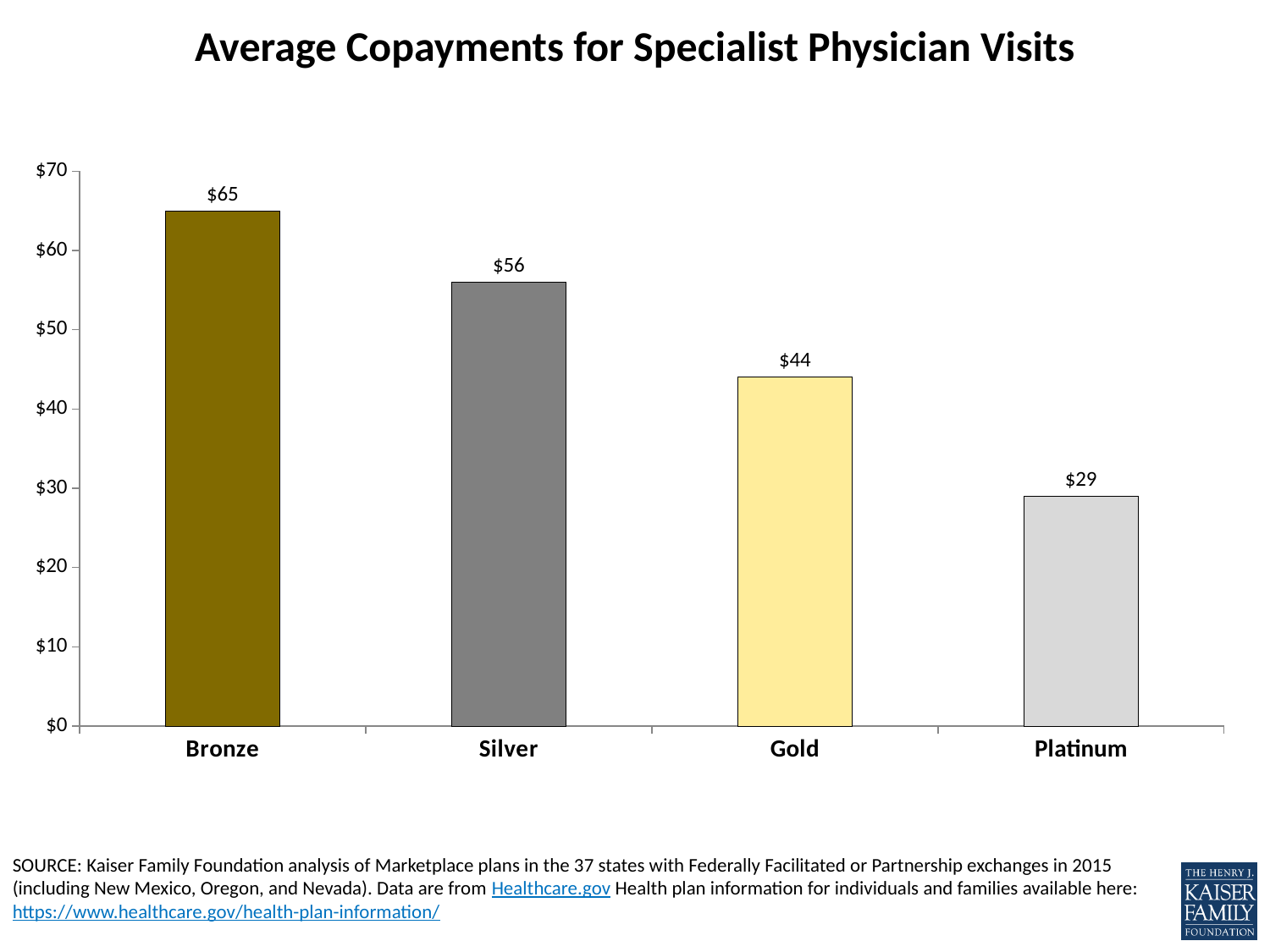
What is the average copayment for specialist physician visits for Platinum plans? $29 Which plan type has the lowest average copayment for specialist physician visits? Platinum How many plan types are shown in the chart? 4 Do the average copayments rise or fall moving from Bronze to Platinum along the x axis? Fall What kind of chart is shown on the slide? Bar chart What is the average copayment for specialist physician visits for Bronze plans? $65 What is the average copayment for specialist physician visits for Silver plans? $56 Which plan type has the highest average copayment for specialist physician visits? Bronze Which has a higher average copayment, Gold or Silver? Silver What is the difference between the average copayments for Bronze and Platinum plans? $36 What is the difference between the average copayments for Silver and Gold plans? $12 What is the average copayment for specialist physician visits for Gold plans? $44